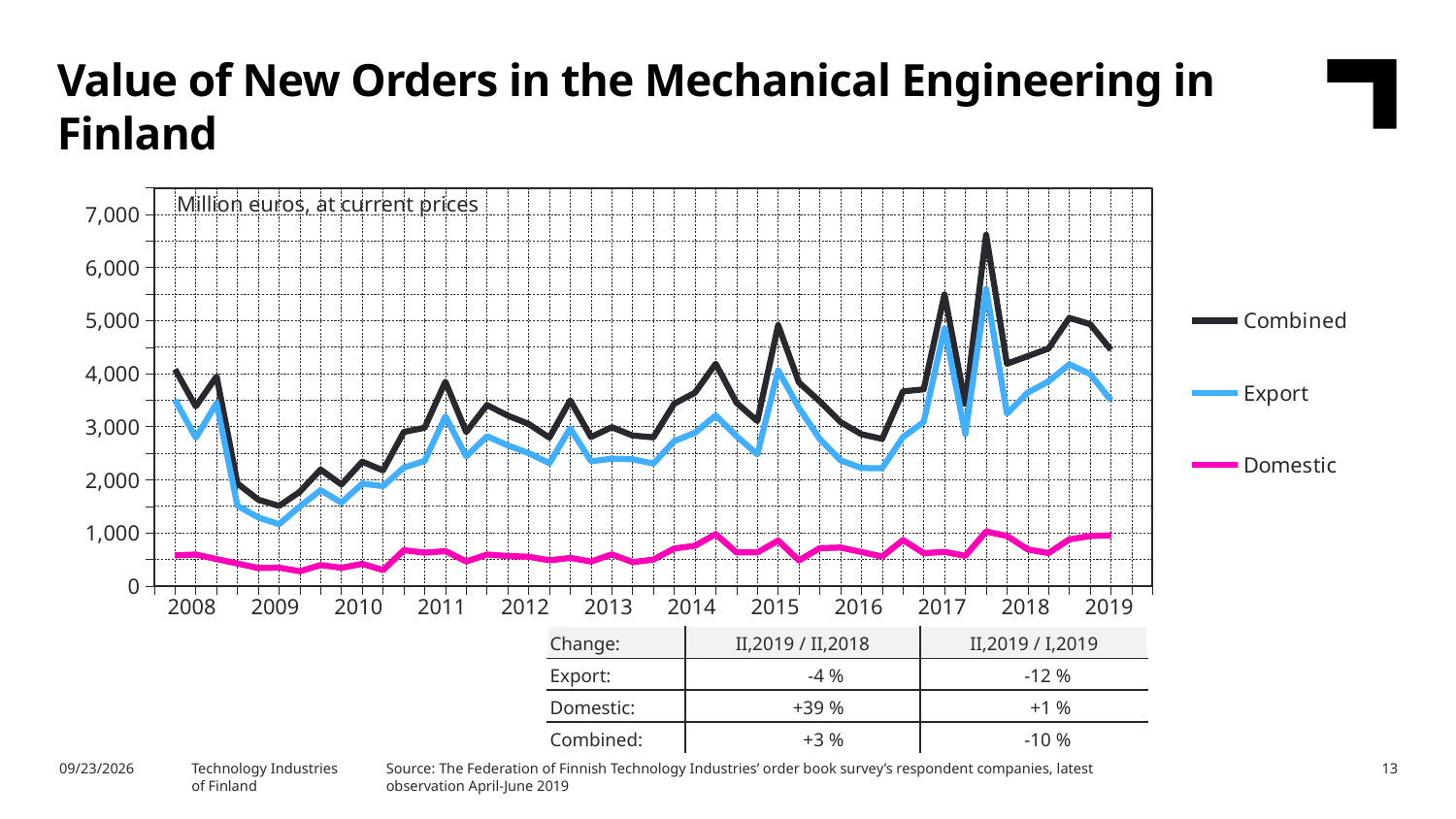
Is the peak value of the Combined series (around 2017-2018) greater or less than 6,000? greater In 2019, which is larger, the Export value or the Domestic value? Export Does the Combined series rise or fall from 2008 to 2009? Fall Is the value of the Export series in 2016 greater or less than 3,000? less What kind of chart is shown on the slide? Line chart How many series does the legend list? 3 Is the value of the Export series in 2009 greater or less than 2,000? less Which series is drawn in pink/magenta? Domestic What unit label is printed inside the chart area? Million euros, at current prices How many years are labelled on the x axis? 12 Which series has the lowest values throughout the period? Domestic